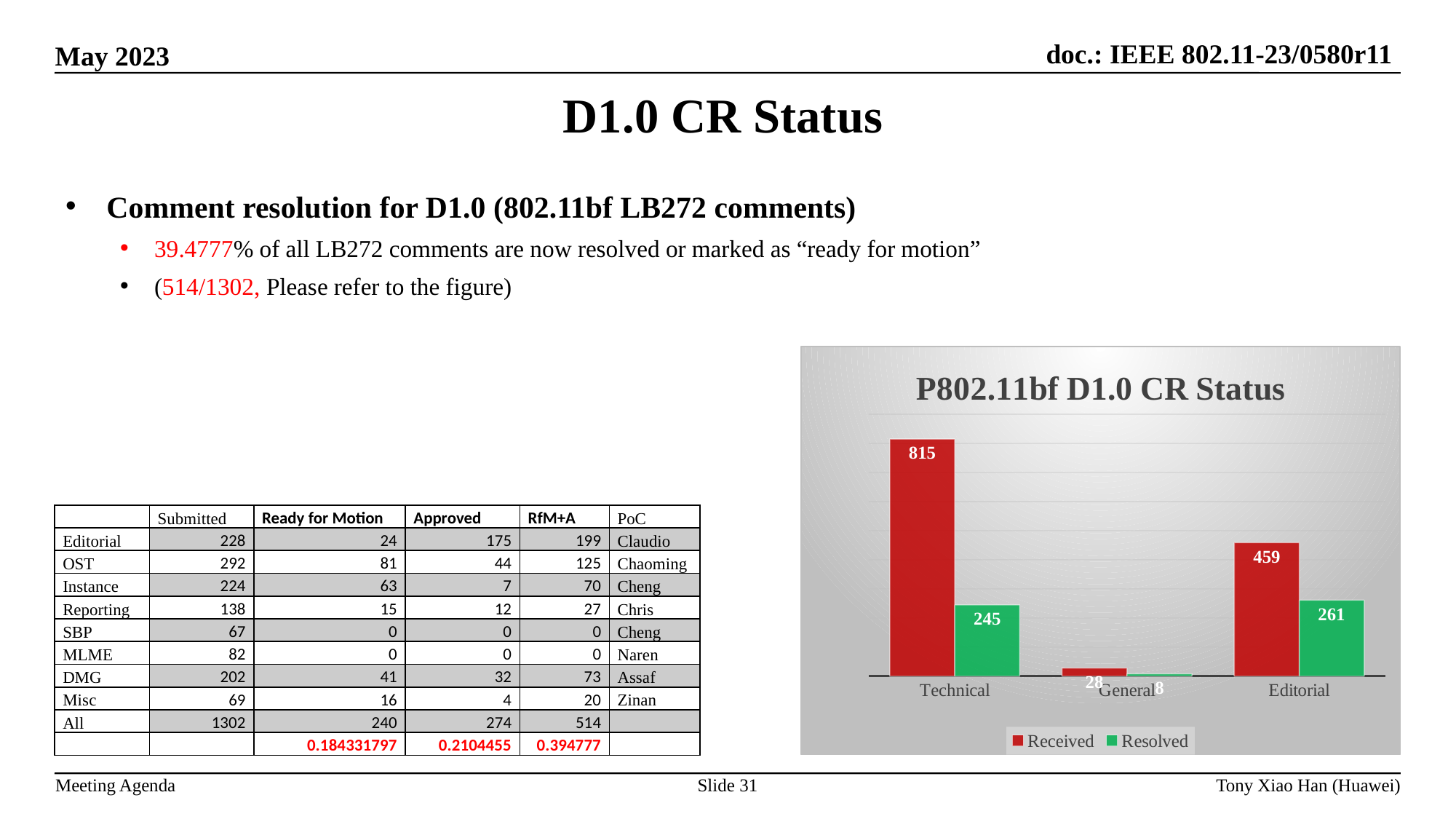
Which is larger, the Resolved value for Editorial or the Resolved value for Technical? Editorial How many categories are shown on the x axis of the chart? 3 What is the title of the chart? P802.11bf D1.0 CR Status What is the Received value for General? 28 Which series is shown in red in the chart? Received Which category has the lowest Resolved value? General Which category has the highest Received value? Technical What is the difference between the Received and Resolved values for Technical? 570 What is the Resolved value for Editorial? 261 How many series does the chart legend list? 2 What kind of chart is shown on the slide? bar chart What is the Received value for Technical? 815